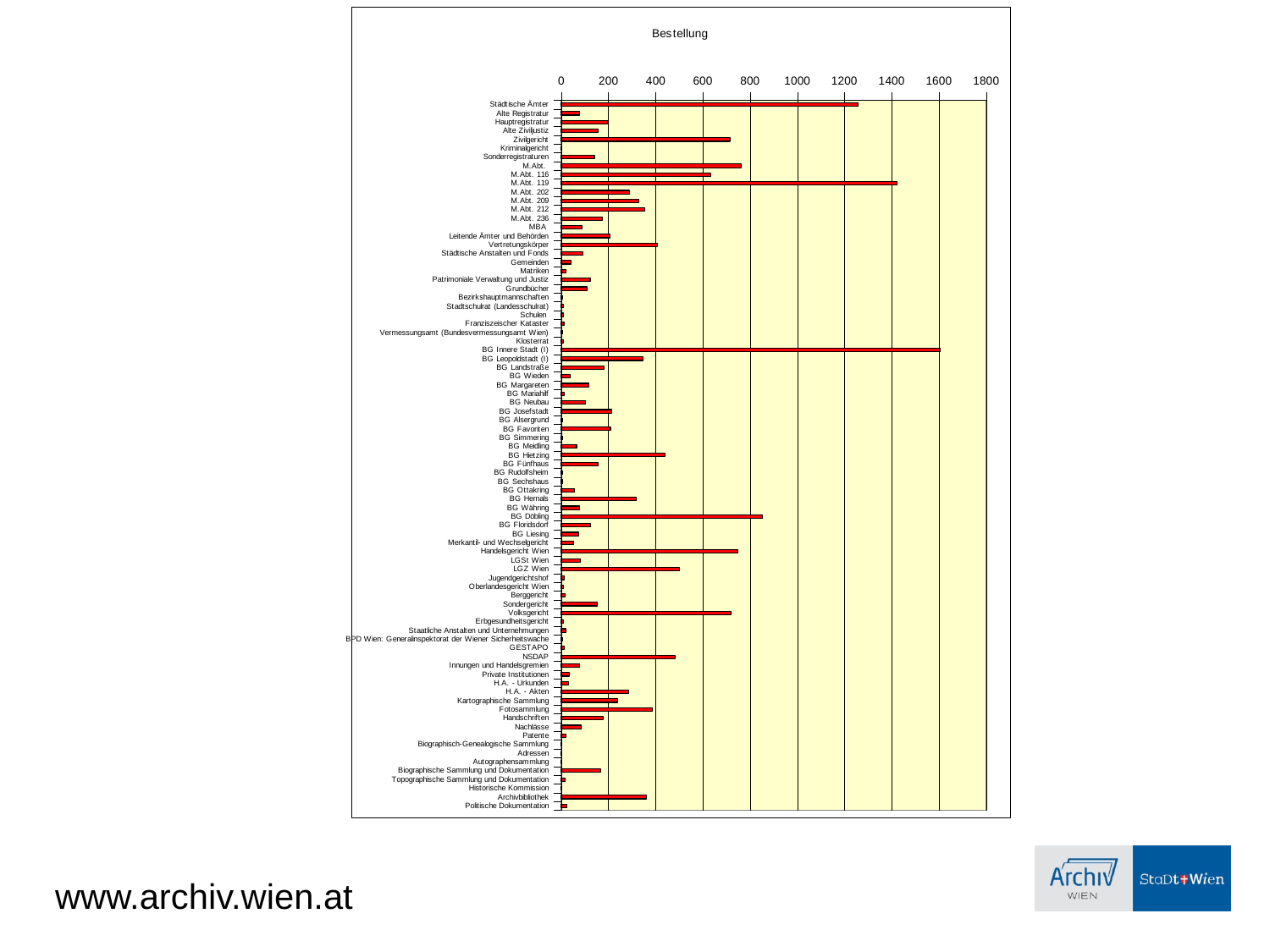
What is the title of the chart? Bestellung Which category has the highest value in the chart? BG Innere Stadt (I) Is the value for BG Hietzing greater or less than 600? less Which has a larger value, M.Abt. 119 or BG Döbling? M.Abt. 119 Which has a larger value, BG Innere Stadt (I) or Städtische Ämter? BG Innere Stadt (I) Is the value for Städtische Ämter greater or less than 1000? greater Is the value for M.Abt. 119 greater or less than 1200? greater What kind of chart is shown on the slide? bar chart